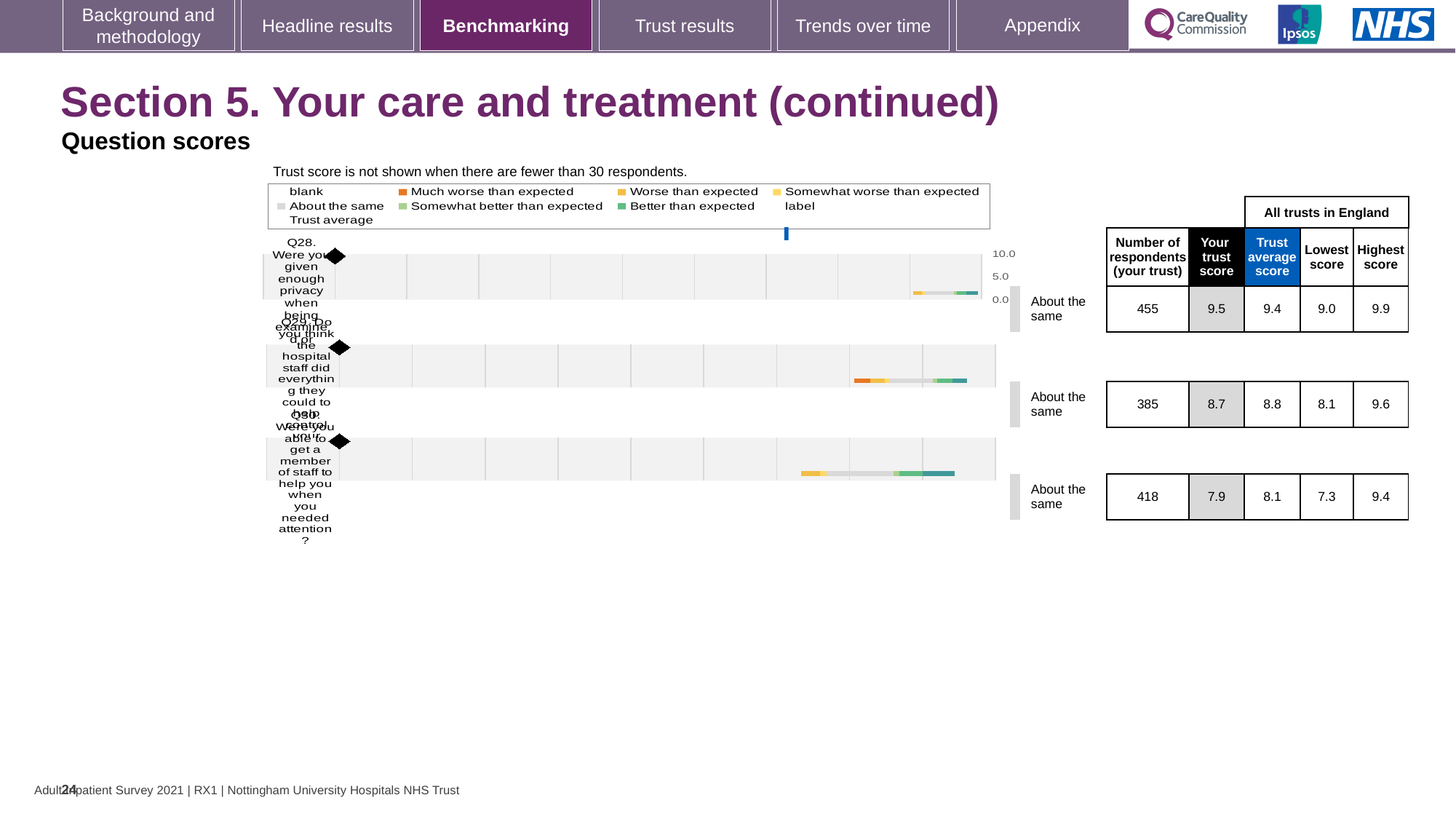
What kind of chart is used to show the question scores? Bar chart Is your trust score for Q30 greater or less than 5.0? greater What is the lowest score across all trusts in England for Q29? 8.1 How many respondents from your trust answered Q29? 385 What is the highest score across all trusts in England for Q30? 9.4 How many questions are plotted on the chart? 3 What benchmark category is shown for all three questions? About the same Which question has the highest 'Your trust score'? Q28 Which question has the lowest 'Your trust score'? Q30 What is the difference between the trust average score and your trust score for Q30? 0.2 What is the 'Your trust score' value for Q28 (Were you given enough privacy when being examined or treated)? 9.5 For Q28, which is larger: your trust score or the trust average score? Your trust score